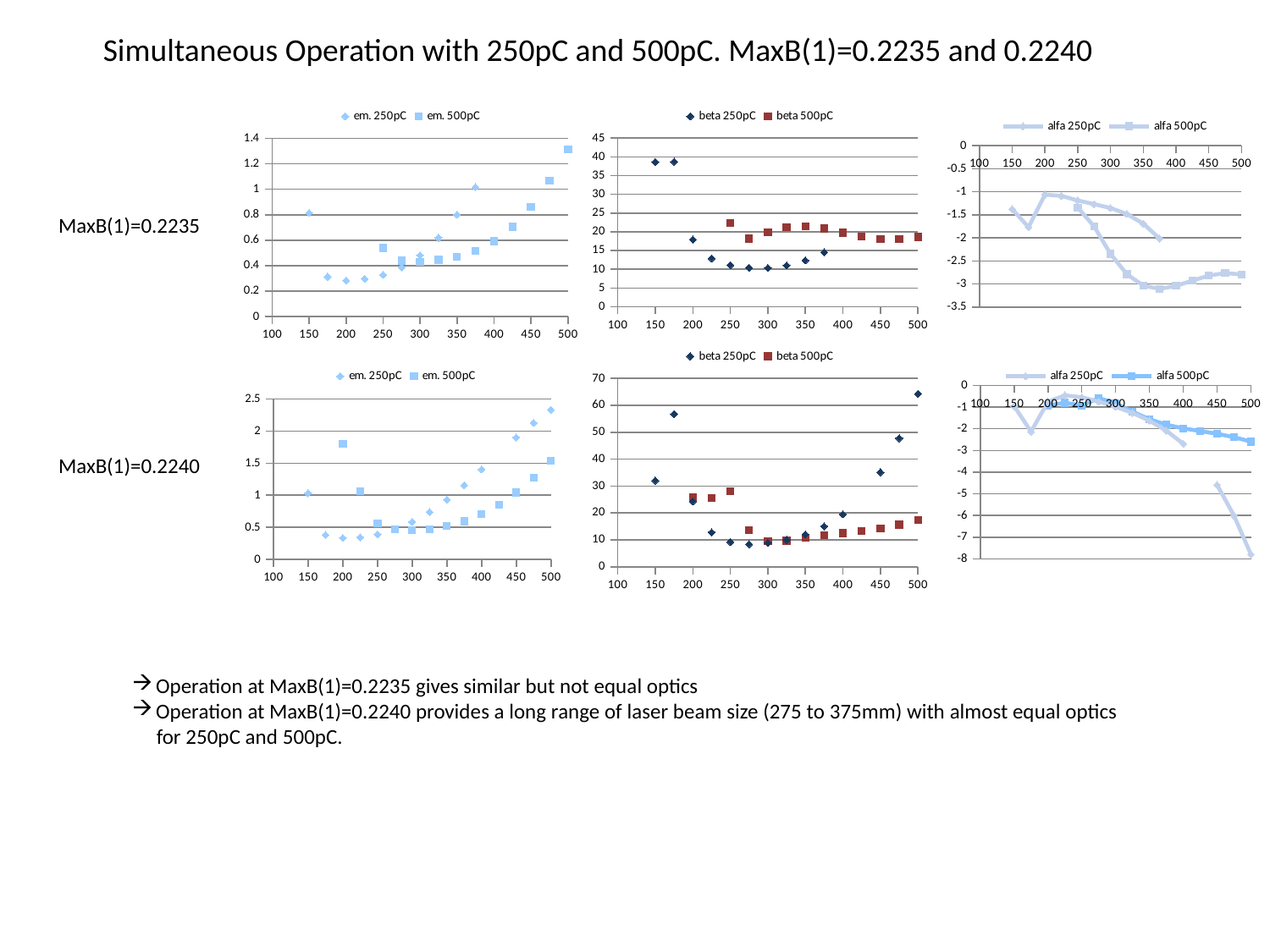
What kind of chart is the top-left em. chart (MaxB(1)=0.2235)? scatter chart On the top-left em. chart (MaxB(1)=0.2235), what are the two legend entries? em. 250pC and em. 500pC On the bottom-left em. chart (MaxB(1)=0.2240), do the em. 250pC values rise or fall from x=200 to x=500? rise On the bottom-middle beta chart (MaxB(1)=0.2240), at x=500 which series has the larger value, beta 250pC or beta 500pC? beta 250pC On the top-left em. chart (MaxB(1)=0.2235), is the em. 500pC value at x=500 greater or less than 1.2? greater On the bottom-left em. chart (MaxB(1)=0.2240), is the em. 500pC value at x=200 greater or less than 1.5? greater On the bottom-right alfa chart (MaxB(1)=0.2240), is the alfa 250pC value at x=500 greater or less than -7? less On the bottom-right alfa chart (MaxB(1)=0.2240), do the alfa 500pC values rise or fall from x=250 to x=500? fall How many series does the legend list on the top-middle beta chart (MaxB(1)=0.2235)? 2 On the top-middle beta chart (MaxB(1)=0.2235), at x=250 which series has the larger value, beta 250pC or beta 500pC? beta 500pC